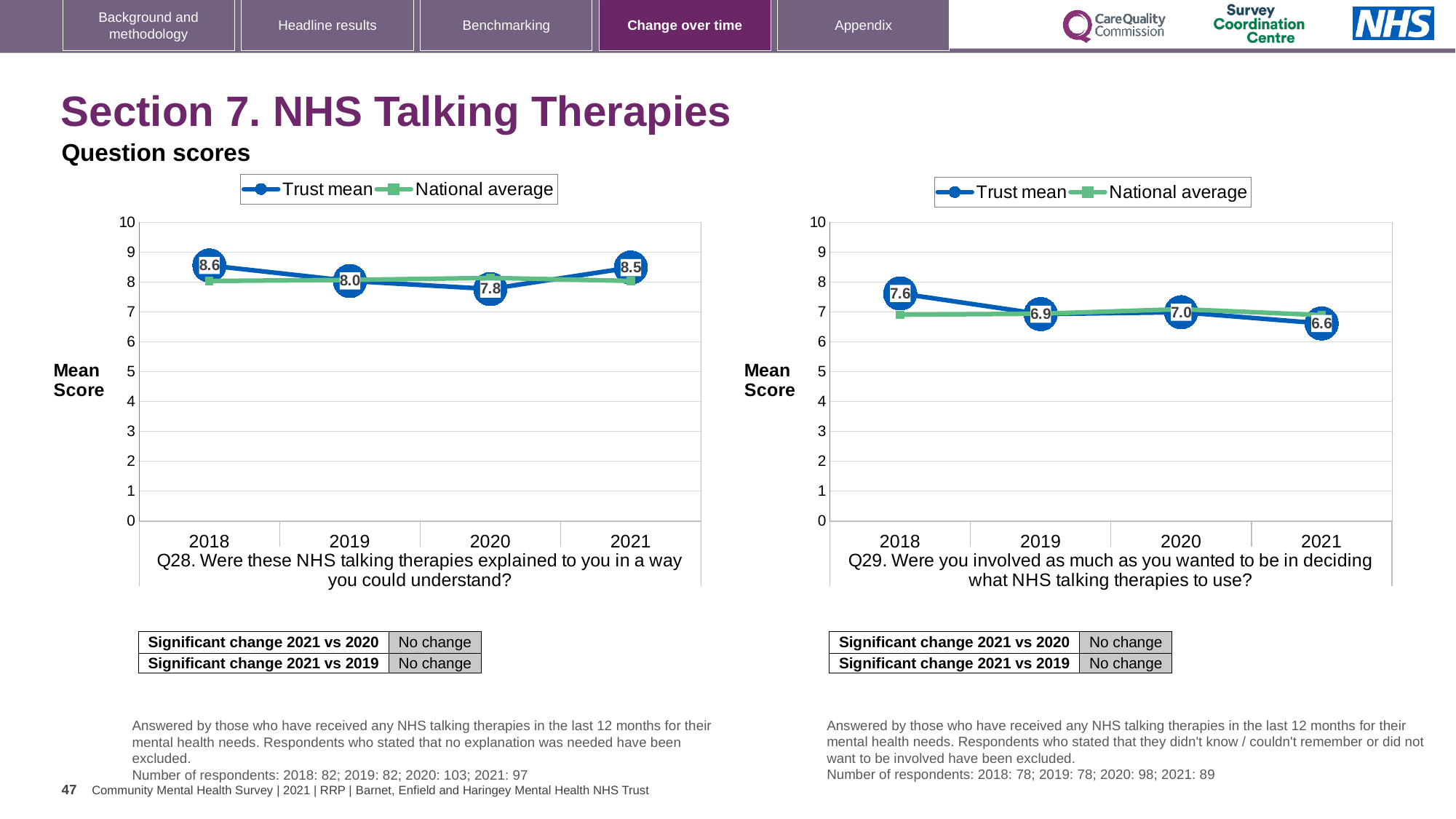
In the Q28 chart (left), which year has the lowest Trust mean? 2020 What kind of chart is the Q29 chart (right)? Line chart How many series does the legend of the Q28 chart (left) list? 2 In the Q28 chart (left), what is the Trust mean for 2018? 8.6 In the Q28 chart (left), is the Trust mean for 2021 greater or less than 8? greater In the Q28 chart (left), what is the difference between the Trust mean in 2018 and in 2020? 0.8 In the Q28 chart (left), what is the Trust mean for 2020? 7.8 In the Q29 chart (right), what is the Trust mean for 2018? 7.6 In the Q29 chart (right), which year has the highest Trust mean? 2018 In the Q29 chart (right), what is the difference between the Trust mean in 2018 and in 2021? 1.0 In the Q29 chart (right), is the Trust mean for 2019 larger or smaller than the Trust mean for 2018? smaller In the Q29 chart (right), what is the Trust mean for 2021? 6.6